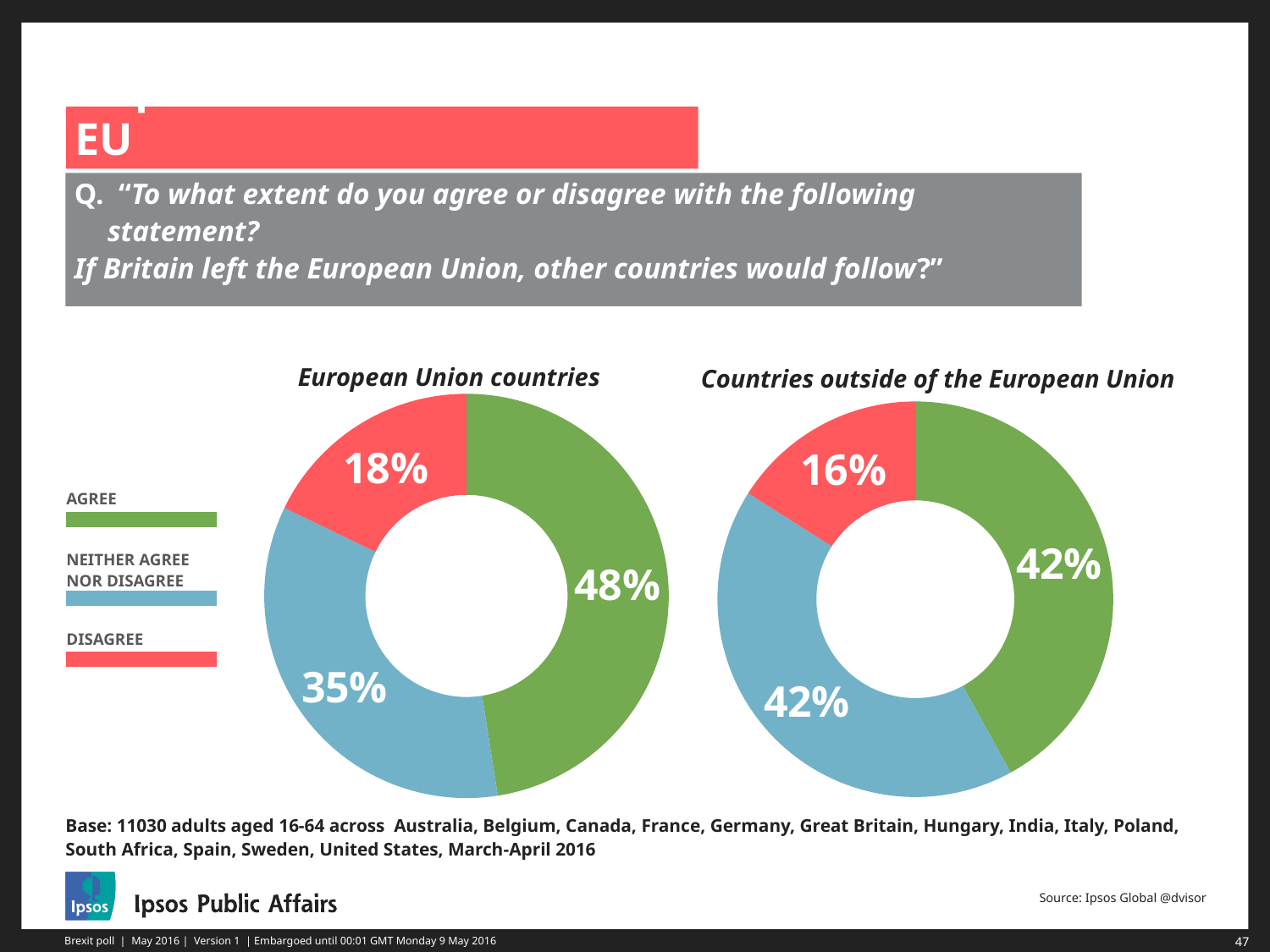
In the 'Countries outside of the European Union' chart, what percentage agree? 42% In the 'Countries outside of the European Union' chart, what percentage disagree? 16% What type of chart is used on this slide? Pie (donut) chart Is the Disagree share larger in the 'European Union countries' chart or the 'Countries outside of the European Union' chart? European Union countries In the 'European Union countries' chart, what percentage neither agree nor disagree? 35% How many response categories does the legend list? 3 In the 'European Union countries' chart, what percentage disagree? 18% In the 'European Union countries' chart, which response has the largest share? Agree In the 'European Union countries' chart, what is the difference between the Agree and Disagree shares? 30 percentage points In the 'Countries outside of the European Union' chart, which response has the smallest share? Disagree In the 'European Union countries' chart, what percentage agree? 48% Which colour represents 'Neither agree nor disagree' in the charts? Blue